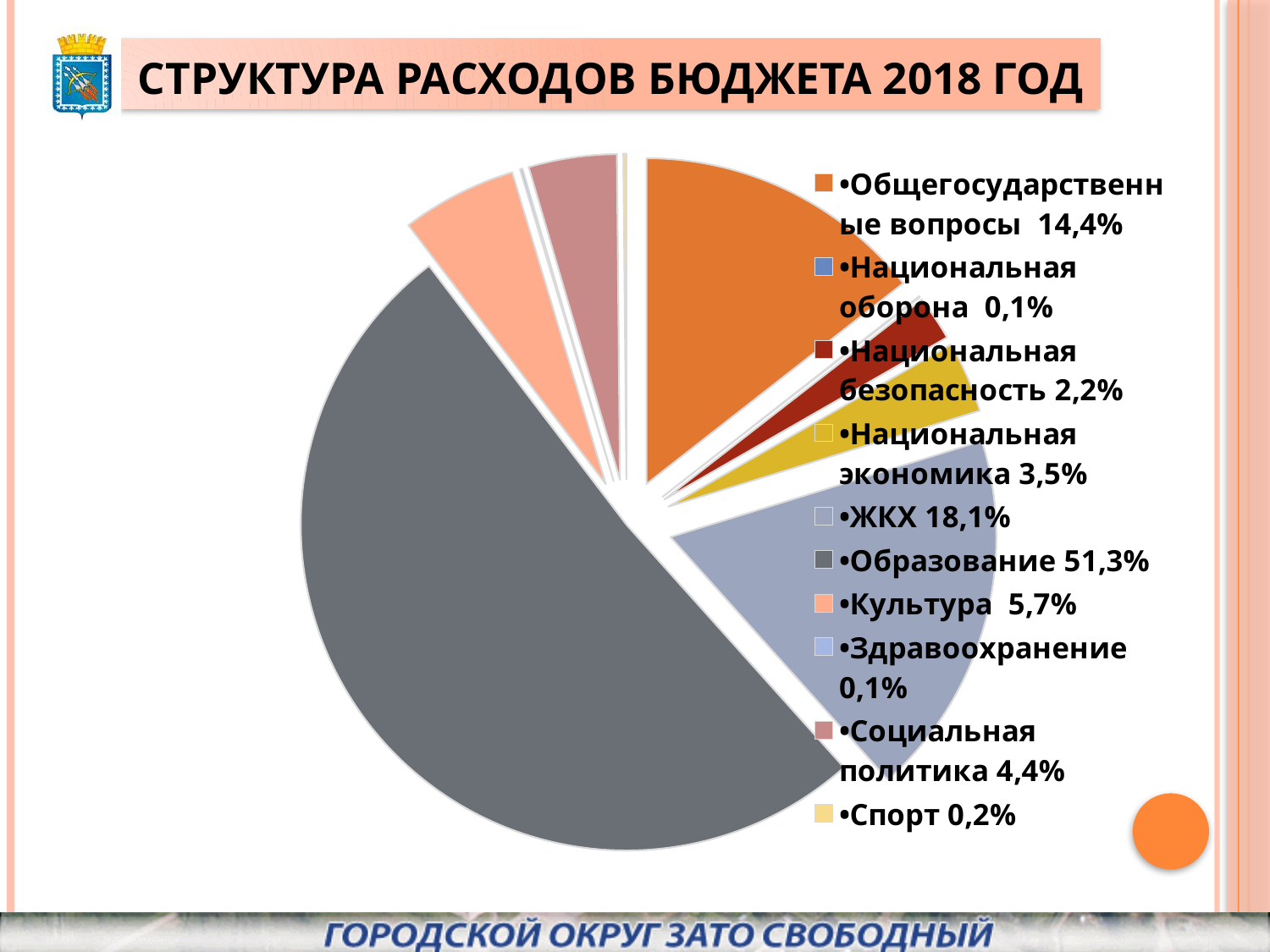
Which is larger, the share for ЖКХ or the share for Общегосударственные вопросы? ЖКХ Which category has the largest share of the pie? Образование What is the value shown for Спорт? 0,2% What kind of chart is shown on the slide? pie chart What is the difference between the shares for Образование and ЖКХ? 33,2% What is the value shown for Культура? 5,7% What is the value shown for ЖКХ? 18,1% How many categories does the pie chart show? 10 What is the value shown for Общегосударственные вопросы? 14,4% What is the title of the chart on the slide? СТРУКТУРА РАСХОДОВ БЮДЖЕТА 2018 ГОД What is the value shown for Социальная политика? 4,4% What share of the budget expenditure goes to Образование? 51,3%